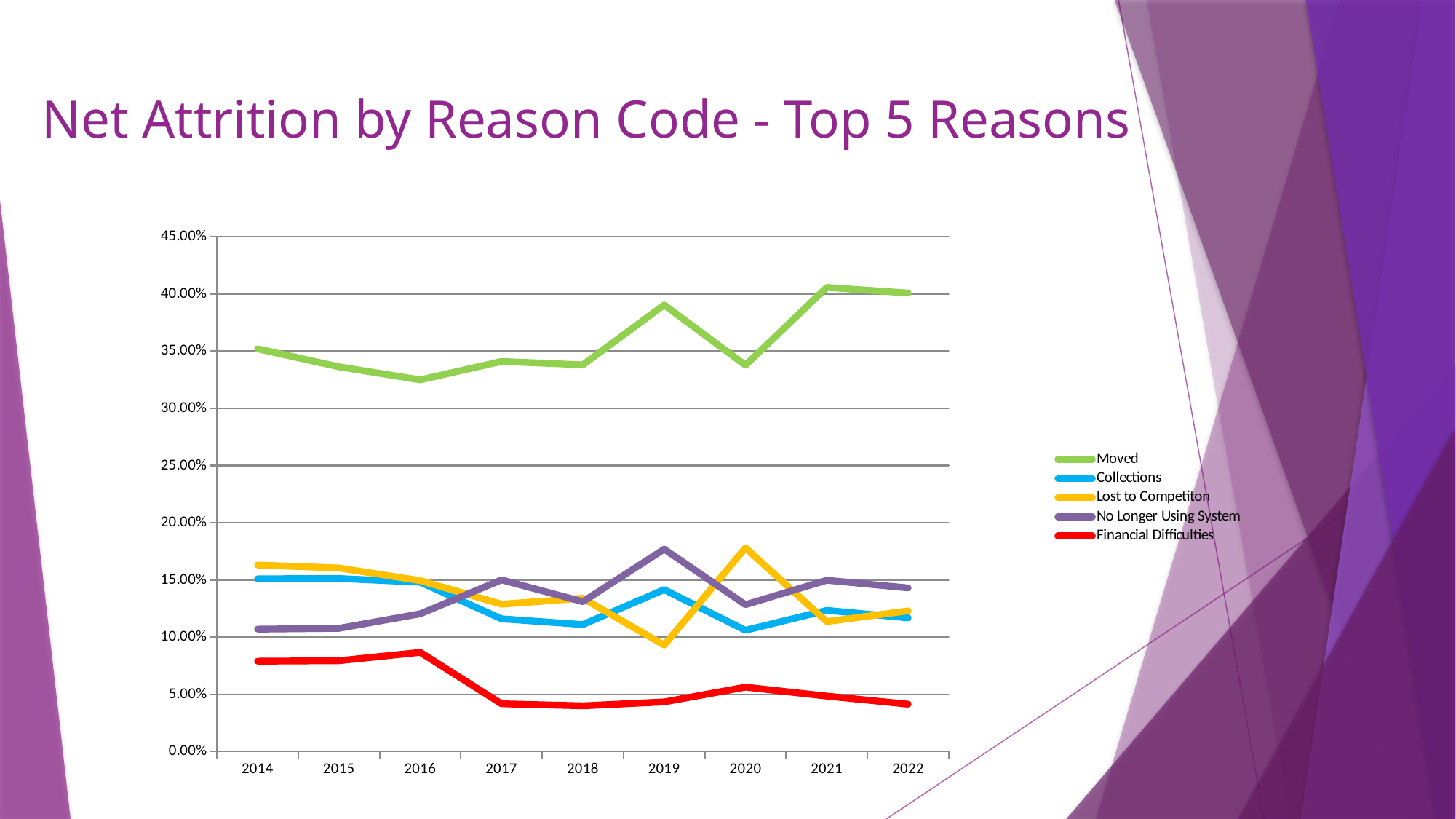
How many years are shown along the x axis? 9 Is the value for Lost to Competiton in 2020 greater or less than 15.00%? greater What colour is the Moved line in the legend? green Is the value for Moved in 2021 greater or less than 35.00%? greater In which year is the Lost to Competiton line at its highest? 2020 In 2019, which is larger: No Longer Using System or Collections? No Longer Using System How many series does the legend list? 5 Is the value for Financial Difficulties in 2017 greater or less than 10.00%? less Does the Financial Difficulties line rise or fall from 2016 to 2017? fall Which reason code has the lowest net attrition in 2022? Financial Difficulties What kind of chart is shown on the slide? line chart Which reason code has the highest net attrition in 2022? Moved